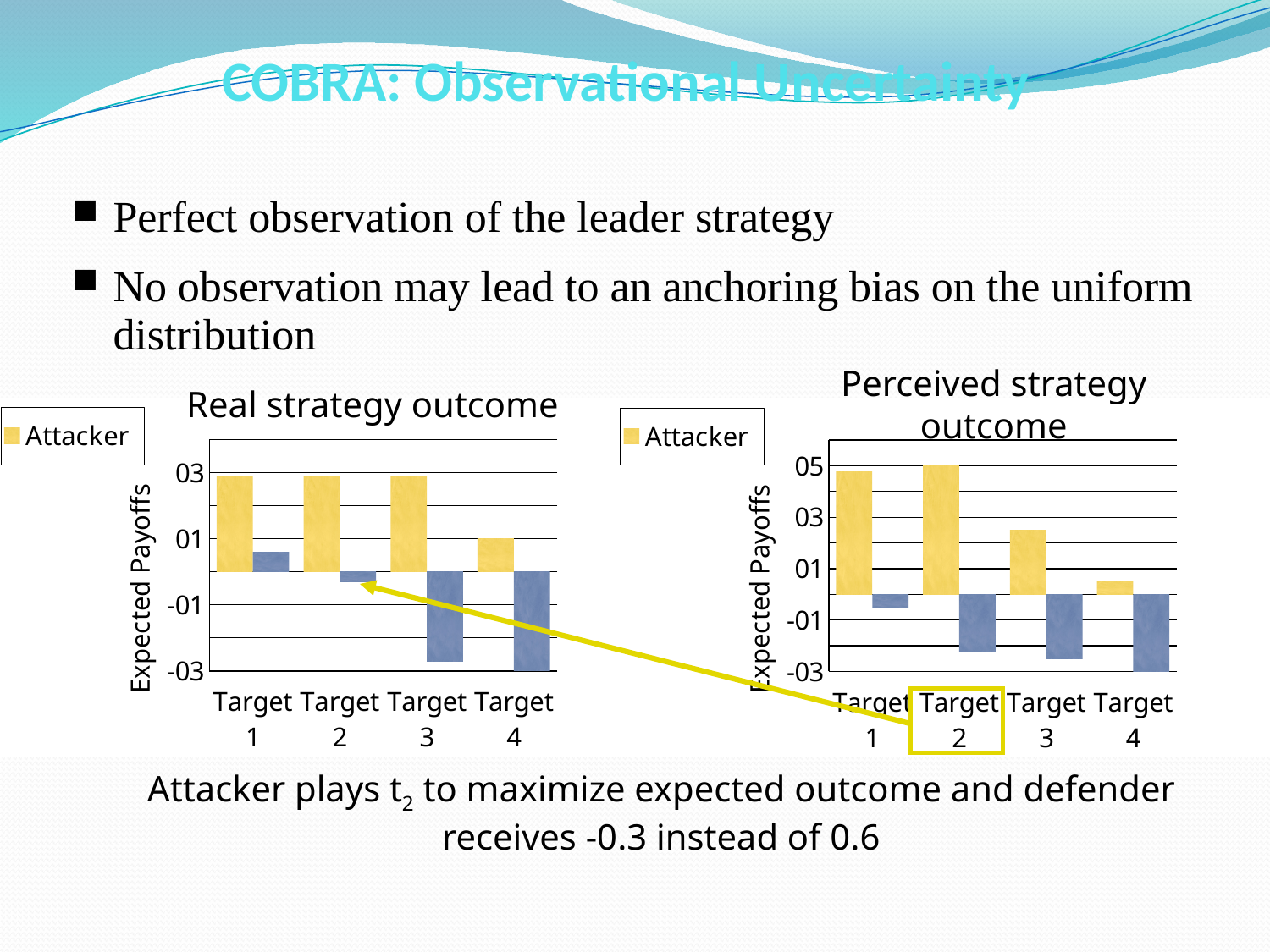
In the "Real strategy outcome" chart, is the Attacker value for Target 1 greater or less than 01? greater In the "Real strategy outcome" chart, is the blue bar for Target 3 greater or less than -01? less What series name is shown in the legend of the "Perceived strategy outcome" chart? Attacker In the "Perceived strategy outcome" chart, is the Attacker value for Target 1 greater or less than 03? greater What kind of chart is the "Real strategy outcome" chart? bar chart What is the y-axis title of the "Real strategy outcome" chart? Expected Payoffs In the "Perceived strategy outcome" chart, which target has the lowest Attacker bar? Target 4 How many targets are shown on the x axis of the "Perceived strategy outcome" chart? 4 In the "Real strategy outcome" chart, which target has the lowest Attacker bar? Target 4 In the "Perceived strategy outcome" chart, which is larger, the Attacker value for Target 3 or for Target 4? Target 3